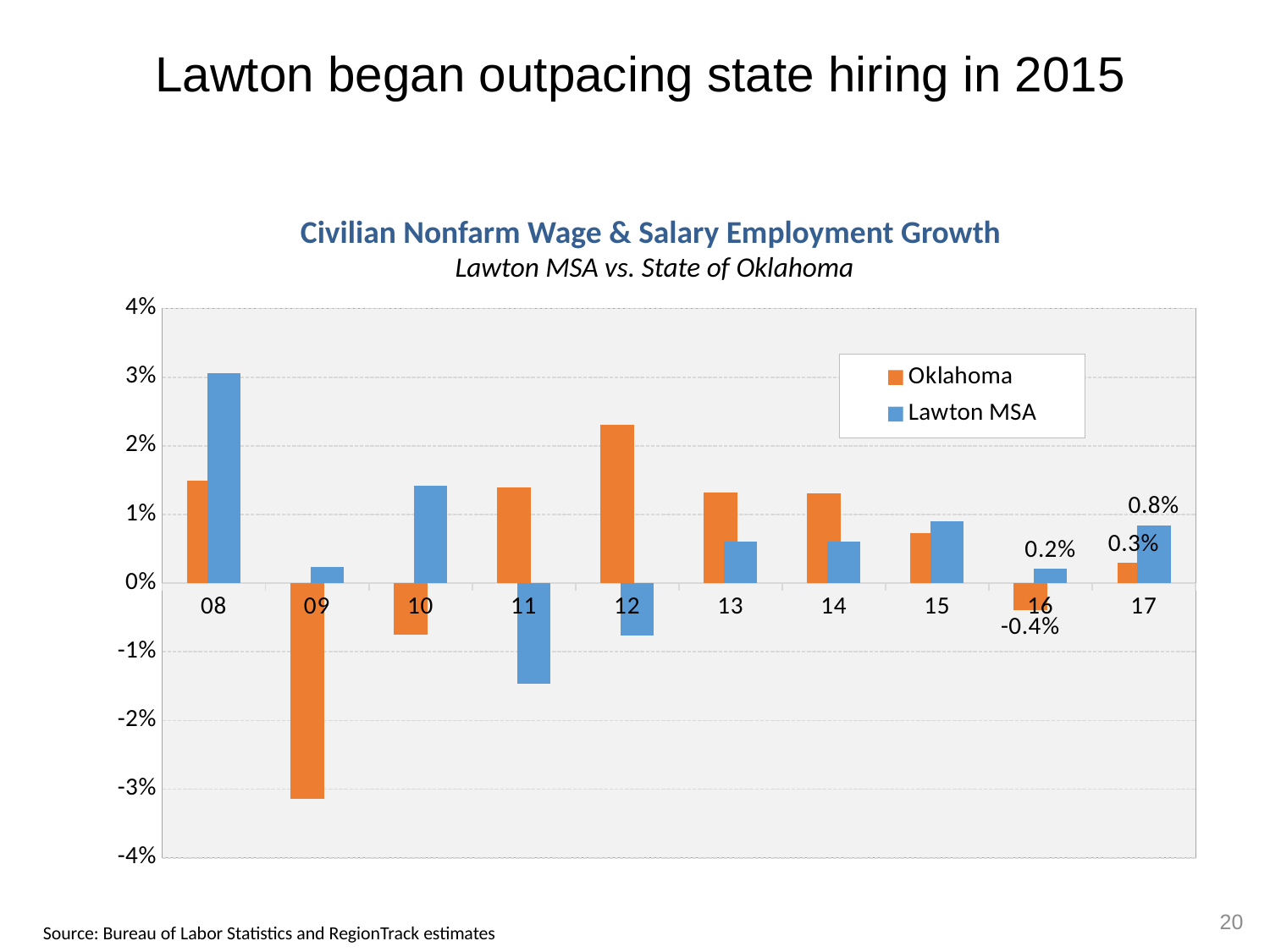
In 16, which series has the larger value, Oklahoma or Lawton MSA? Lawton MSA Is the value for Lawton MSA in 08 greater or less than 2%? greater What kind of chart is shown on the slide? Bar chart In 17, how much higher is the Lawton MSA value than the Oklahoma value? 0.5% In which year is the Oklahoma value highest? 12 How many years are shown on the x axis? 10 How many series does the legend list? 2 What is the value for Oklahoma in 17? 0.3% What is the value for Oklahoma in 16? -0.4% What is the value for Lawton MSA in 16? 0.2% What is the value for Lawton MSA in 17? 0.8% In which year is the Lawton MSA value lowest? 11